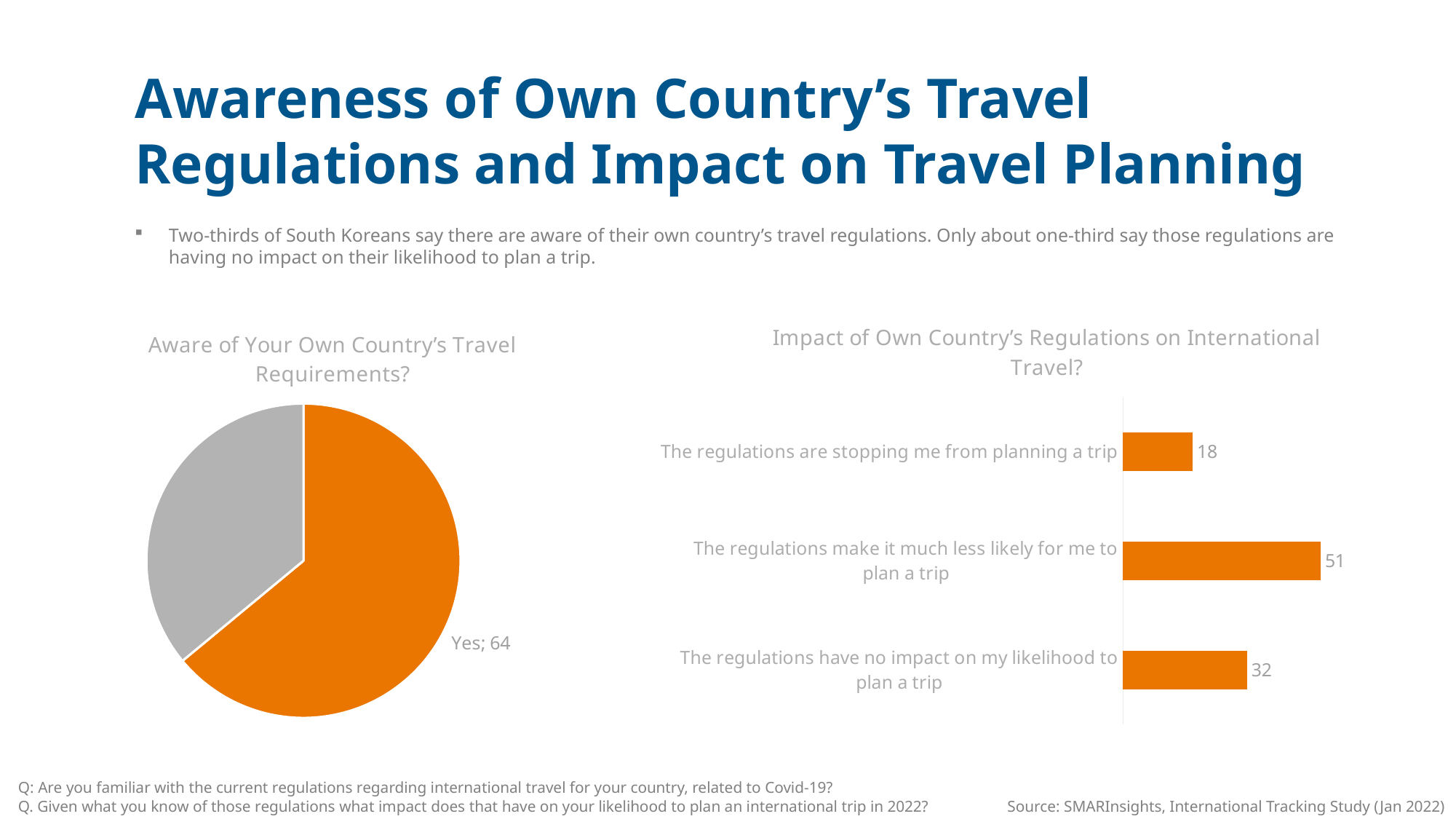
In the 'Impact of Own Country's Regulations on International Travel?' chart, which is larger: 'The regulations have no impact on my likelihood to plan a trip' or 'The regulations are stopping me from planning a trip'? The regulations have no impact on my likelihood to plan a trip In the 'Impact of Own Country's Regulations on International Travel?' chart, what is the value for 'The regulations are stopping me from planning a trip'? 18 In the 'Impact of Own Country's Regulations on International Travel?' chart, what is the difference between the values for 'The regulations make it much less likely for me to plan a trip' and 'The regulations have no impact on my likelihood to plan a trip'? 19 In the 'Impact of Own Country's Regulations on International Travel?' chart, which category has the highest value? The regulations make it much less likely for me to plan a trip How many categories are shown in the 'Impact of Own Country's Regulations on International Travel?' chart? 3 In the 'Impact of Own Country's Regulations on International Travel?' chart, which category has the lowest value? The regulations are stopping me from planning a trip In the 'Impact of Own Country's Regulations on International Travel?' chart, what is the value for 'The regulations make it much less likely for me to plan a trip'? 51 What kind of chart is 'Impact of Own Country's Regulations on International Travel?'? bar chart What kind of chart is 'Aware of Your Own Country's Travel Requirements?'? pie chart In the 'Aware of Your Own Country's Travel Requirements?' pie chart, what colour is the 'Yes' slice? orange In the 'Impact of Own Country's Regulations on International Travel?' chart, what is the value for 'The regulations have no impact on my likelihood to plan a trip'? 32 In the 'Aware of Your Own Country's Travel Requirements?' chart, what value is shown for the 'Yes' slice? 64